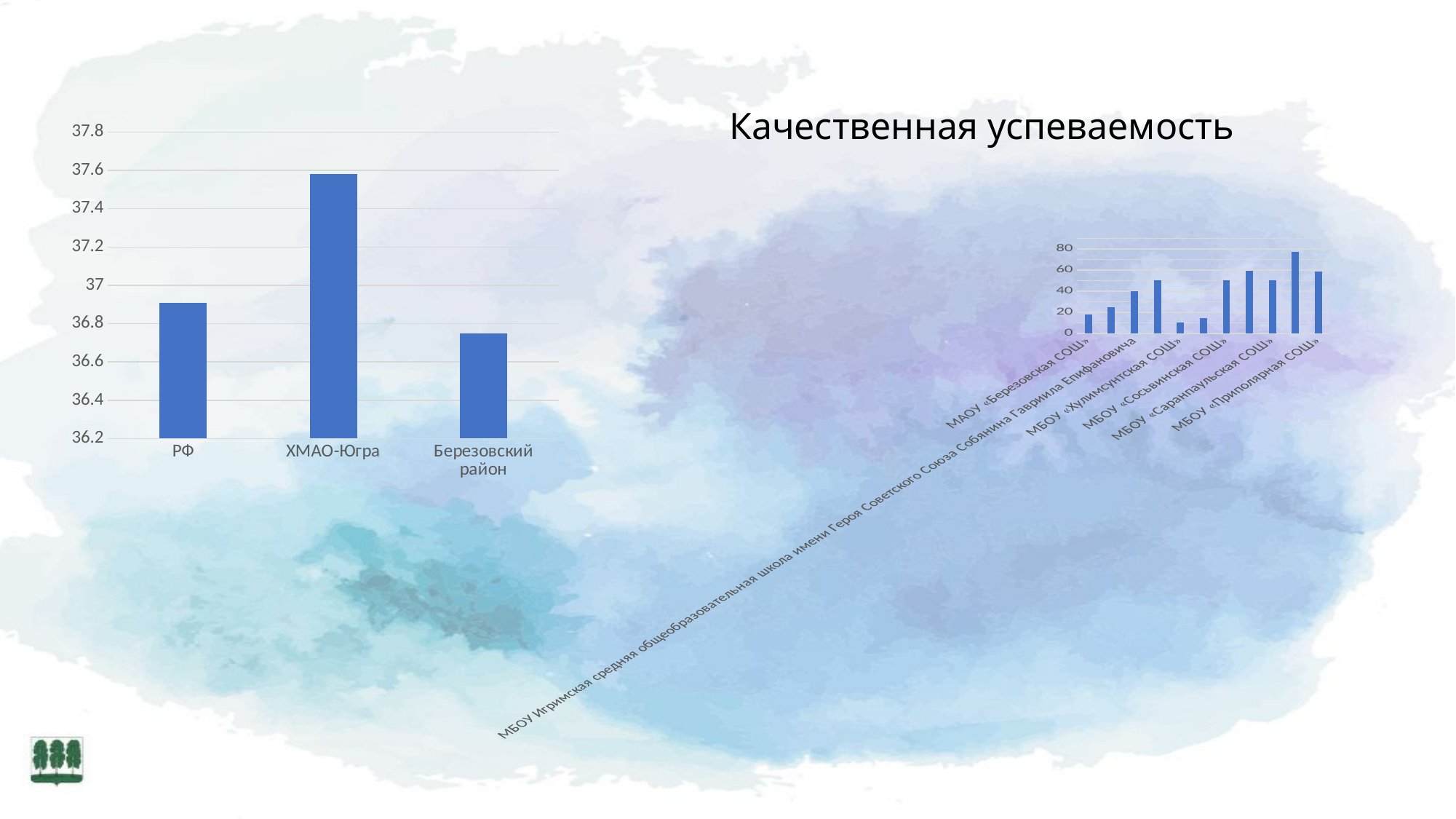
What is the lowest value shown on the vertical axis of the chart on the left of the slide? 36.2 How many categories does the chart on the left of the slide show? 3 How many bars does the small chart on the right of the slide show? 11 In the chart on the left of the slide, is the value for Березовский район greater or less than 36.8? less In the chart on the left of the slide, which is larger, the value for РФ or the value for Березовский район? РФ In the chart on the left of the slide, is the value for РФ greater or less than 37? less In the chart on the left of the slide, which category has the highest value? ХМАО-Югра In the chart on the left of the slide, is the value for ХМАО-Югра greater or less than 37.4? greater What kind of chart is the chart on the left of the slide? bar chart In the chart on the left of the slide, which category has the lowest value? Березовский район What kind of chart is the small chart on the right of the slide? bar chart What title is shown above the chart on the right of the slide? Качественная успеваемость